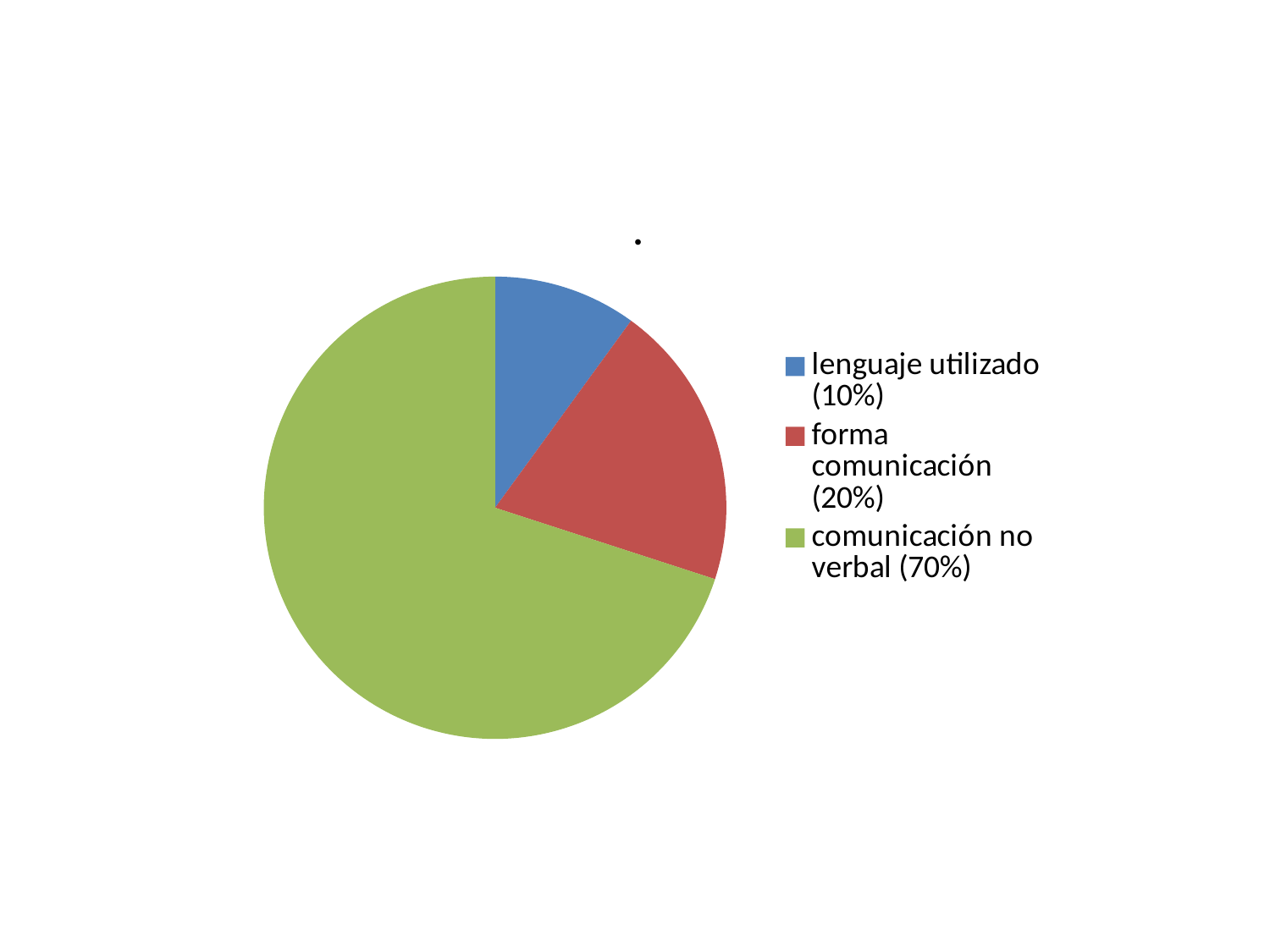
What is the difference in percentage points between 'forma comunicación' and 'lenguaje utilizado'? 10 Which category has the smallest slice of the pie? lenguaje utilizado What kind of chart is shown on the slide? pie chart Which is larger, the slice for 'forma comunicación' or the slice for 'lenguaje utilizado'? forma comunicación What share of the pie does 'forma comunicación' represent? 20% Which category has the largest slice of the pie? comunicación no verbal What share of the pie does 'comunicación no verbal' represent? 70% What share of the pie does 'lenguaje utilizado' represent? 10% How many slices does the pie chart have? 3 What is the difference in percentage points between 'comunicación no verbal' and 'forma comunicación'? 50 What colour is the slice for 'comunicación no verbal'? green How many entries does the legend list? 3